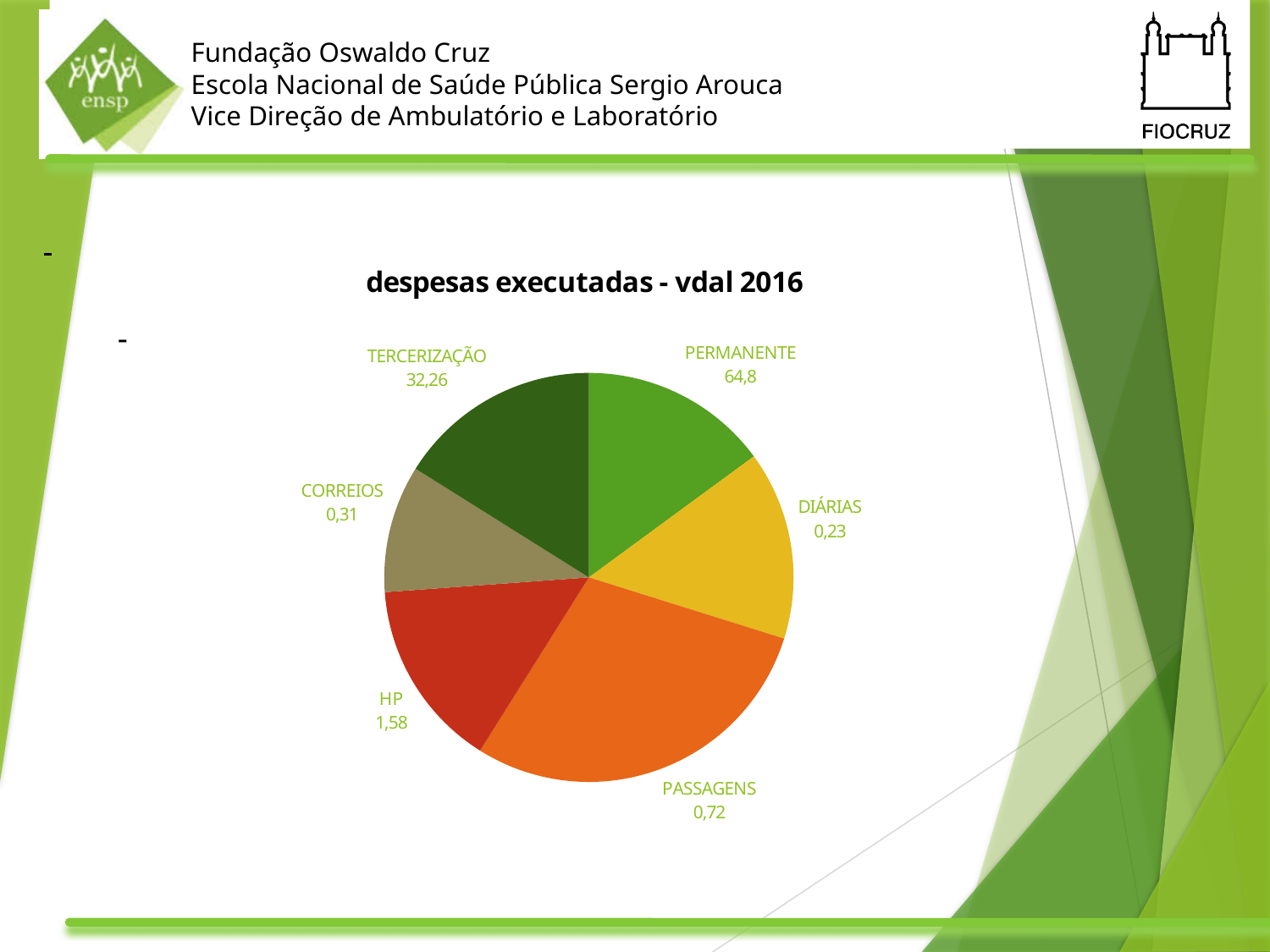
What value is labelled for PASSAGENS? 0,72 What value is labelled for DIÁRIAS? 0,23 What kind of chart is shown on the slide? Pie chart What is the difference between the labelled values for PERMANENTE and TERCERIZAÇÃO? 32,54 What is the value shown for HP? 1,58 What is the difference between the labelled values for HP and PASSAGENS? 0,86 What is the title of the chart? despesas executadas - vdal 2016 Which slice is labelled with the value 0,31? CORREIOS What is the value shown for PERMANENTE in the pie chart? 64,8 How many slices does the pie chart have? 6 What is the value shown for TERCERIZAÇÃO? 32,26 What is the value shown for CORREIOS? 0,31